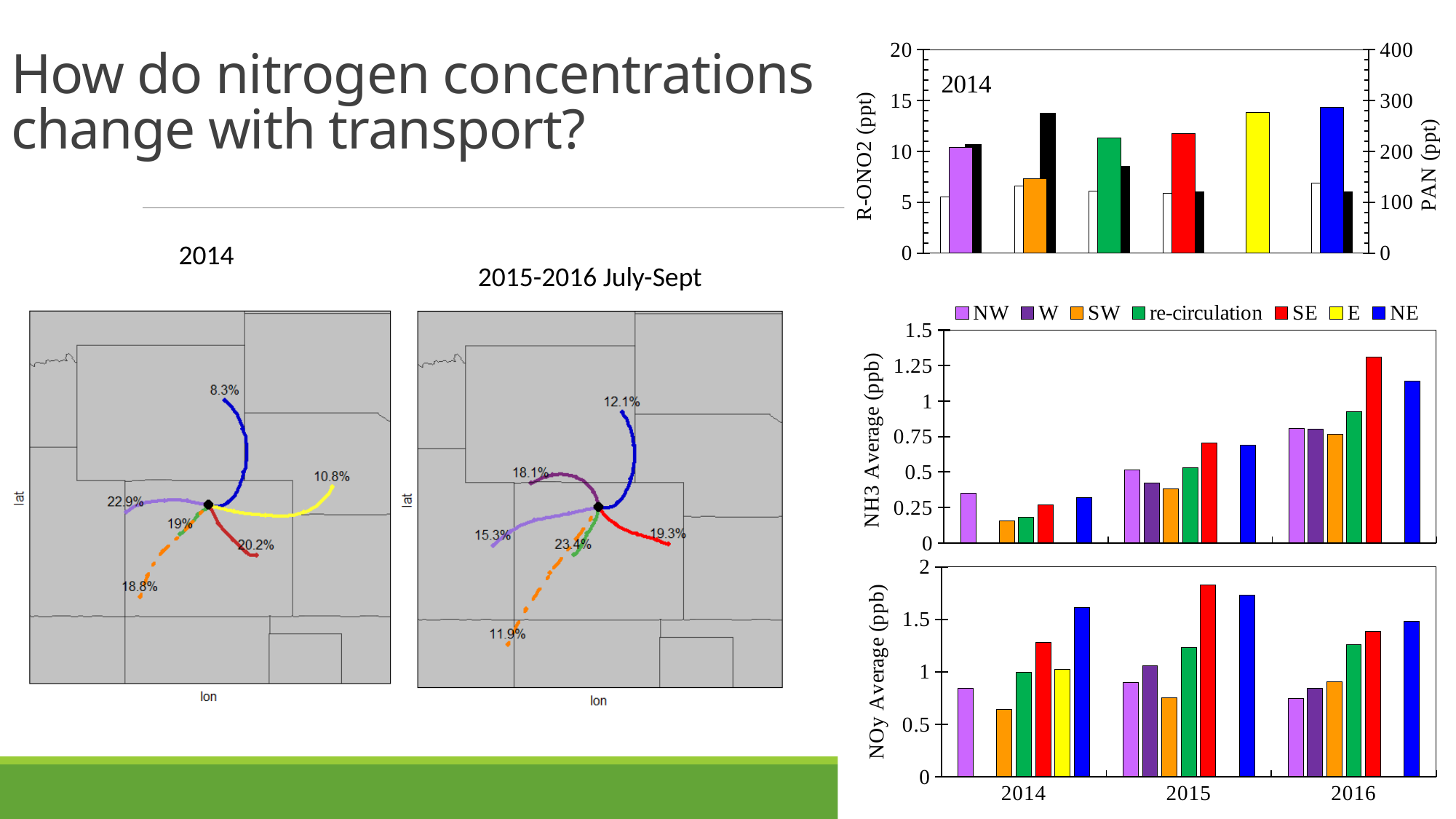
In the NOy Average (ppb) chart, which year and direction has the highest bar? SE in 2015 In the NH3 Average (ppb) chart, is the value for SE in 2016 greater or less than 1? greater In the NOy Average (ppb) chart, is the value for NE in 2014 greater or less than 1.5? greater How many series does the legend above the NH3 Average chart list? 7 In the NH3 Average (ppb) chart, does the NE value rise or fall from 2014 to 2016? rise What is the label on the right-hand y axis of the top-right chart labelled 2014? PAN (ppt) What kind of chart is the NH3 Average (ppb) chart? bar chart In the NOy Average (ppb) chart, is the value for NW in 2016 greater or less than 1? less In the NOy Average (ppb) chart, which is larger: SE in 2015 or SE in 2016? SE in 2015 On the 2014 trajectory map, what percentage is labelled on the blue trajectory heading north? 8.3% In the NH3 Average (ppb) chart, which year and direction has the highest bar? SE in 2016 How many year categories are shown on the x axis of the NOy Average (ppb) chart? 3